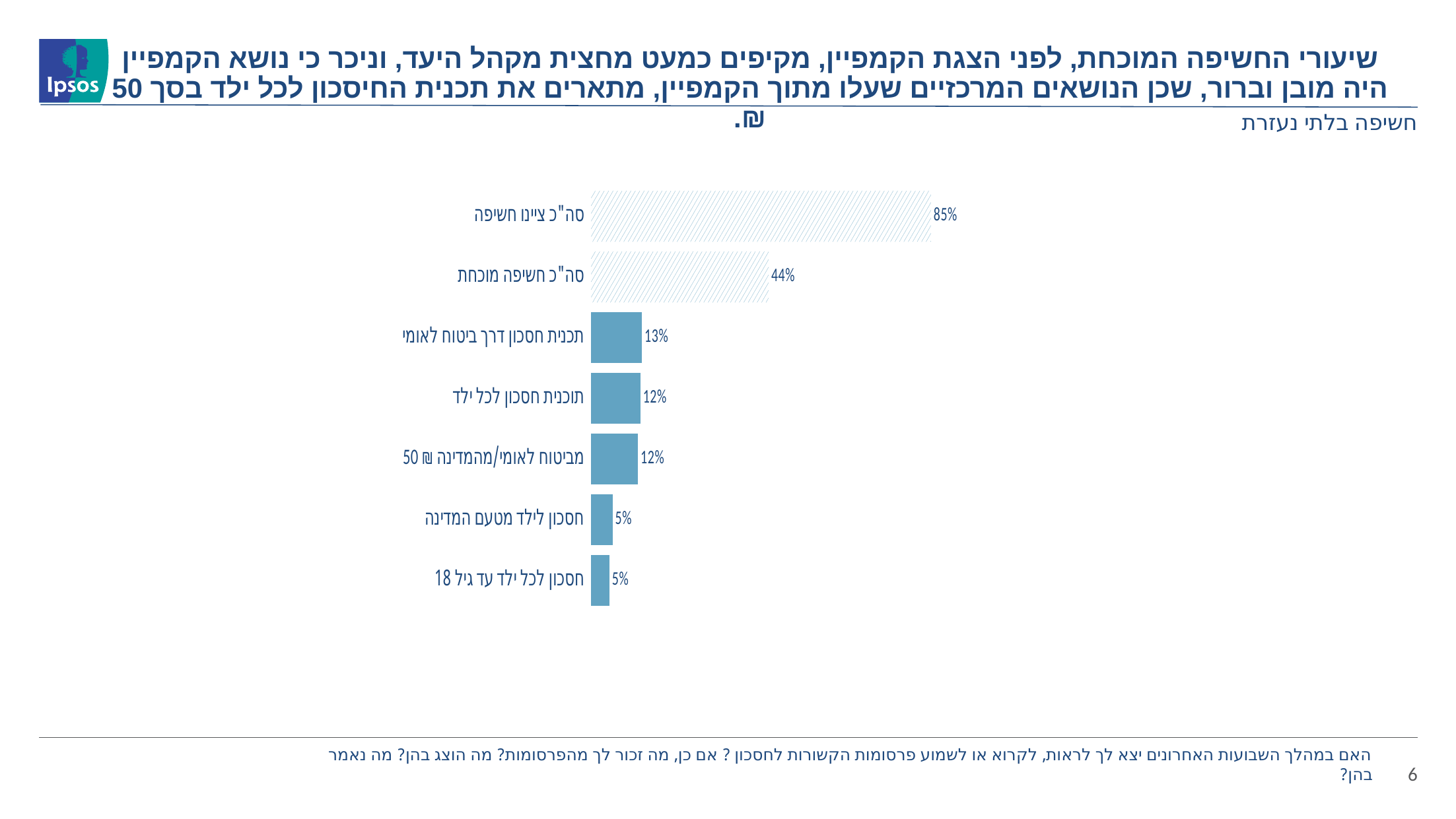
What is the value for תוכנית חסכון לכל ילד? 12% What is the value for סה"כ חשיפה מוכחת? 44% What is the difference between the values for סה"כ ציינו חשיפה and סה"כ חשיפה מוכחת? 41% Which bars in the chart are drawn with a hatched pattern rather than solid fill? סה"כ ציינו חשיפה and סה"כ חשיפה מוכחת How many categories are shown in the chart? 7 What is the value for חסכון לילד מטעם המדינה? 5% What is the value for תכנית חסכון דרך ביטוח לאומי? 13% Which is larger, the value for סה"כ חשיפה מוכחת or the value for תכנית חסכון דרך ביטוח לאומי? סה"כ חשיפה מוכחת Which category has the highest value? סה"כ ציינו חשיפה What is the difference between the values for תכנית חסכון דרך ביטוח לאומי and חסכון לכל ילד עד גיל 18? 8% What is the value for סה"כ ציינו חשיפה? 85% What kind of chart is shown on the slide? Bar chart